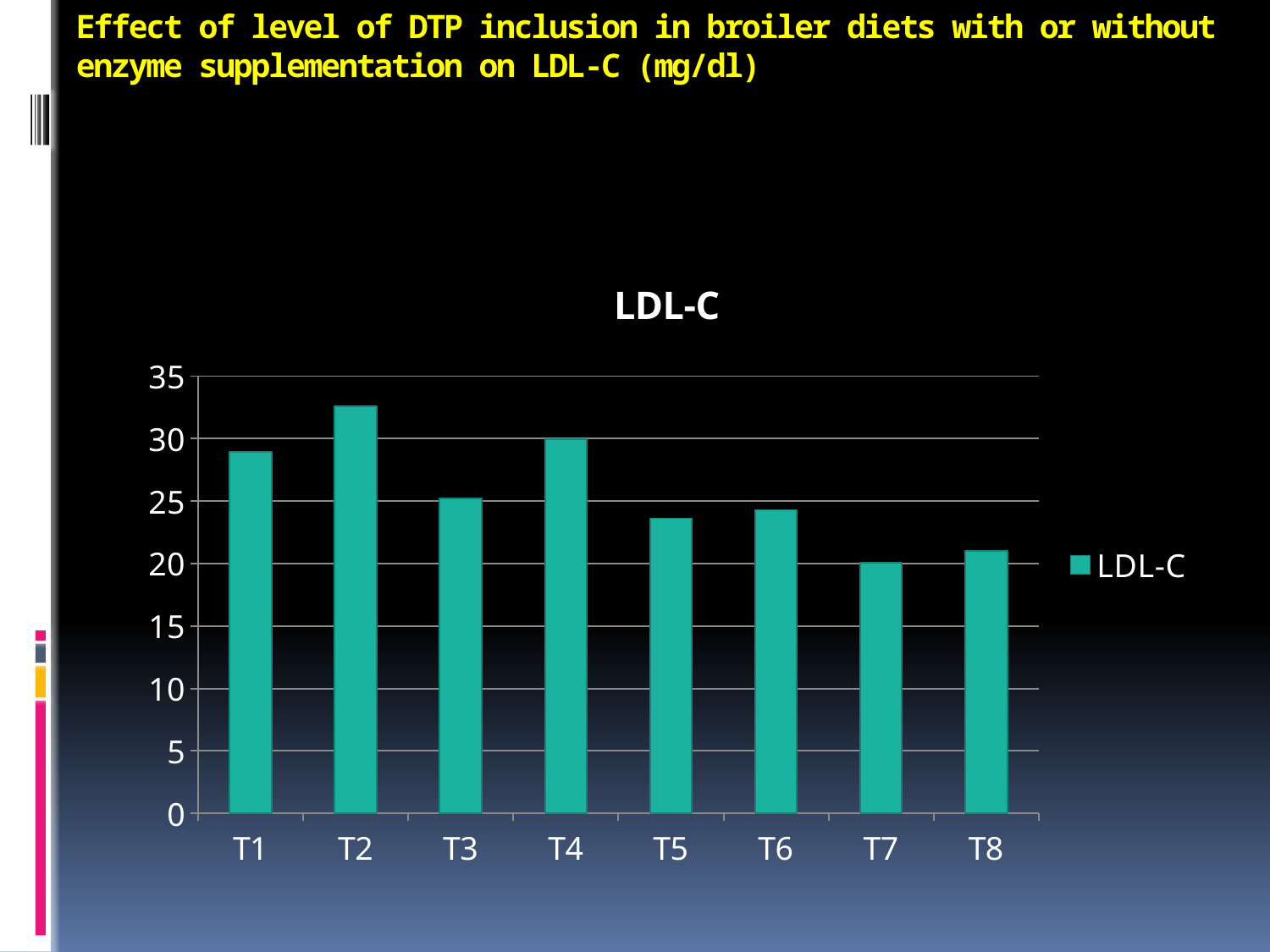
Is the value for T5 greater or less than 20? greater Do the LDL-C values generally rise or fall from T1 to T8? fall Is the value for T2 greater or less than 30? greater Which is larger, the value for T3 or the value for T5? T3 How many series does the legend list? 1 What kind of chart is shown on the slide? bar chart What is the title shown above the chart? LDL-C How many categories are plotted on the x axis? 8 Which is larger, the value for T2 or the value for T1? T2 Which treatment has the highest LDL-C value? T2 Which treatment has the lowest LDL-C value? T7 Is the value for T5 greater or less than 25? less